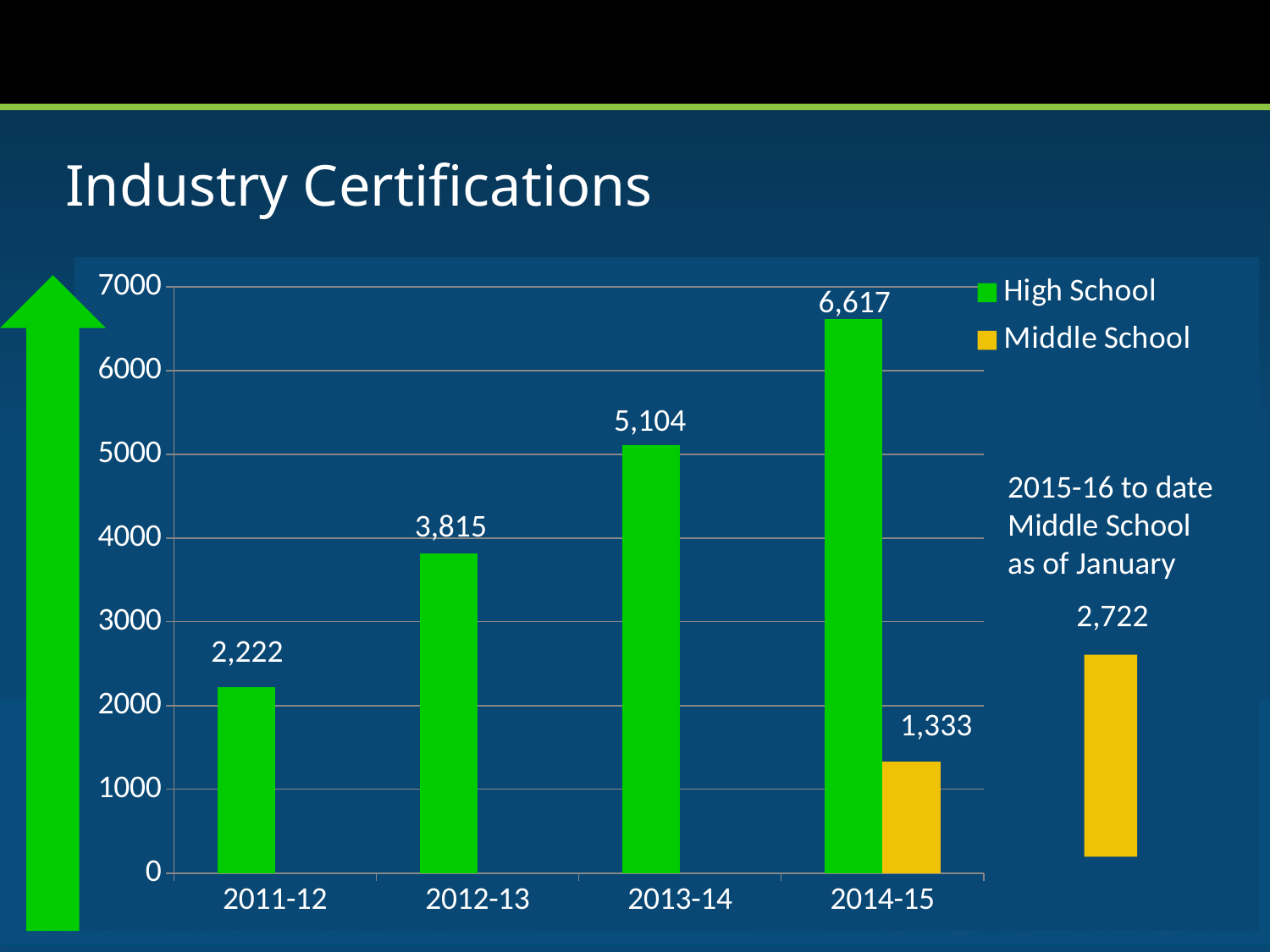
How many years are shown on the x axis? 4 What is the difference between the High School values for 2014-15 and 2013-14? 1,513 Do the High School values rise or fall from 2011-12 to 2014-15? Rise What is the High School value for 2011-12? 2,222 How many series does the legend list? 2 What is the Middle School value for 2014-15? 1,333 What kind of chart is this? Bar chart Which is larger, the High School value for 2012-13 or the High School value for 2013-14? 2013-14 Which year has the highest High School value? 2014-15 What is the High School value for 2013-14? 5,104 Which year has the lowest High School value? 2011-12 What is the difference between the High School and Middle School values for 2014-15? 5,284